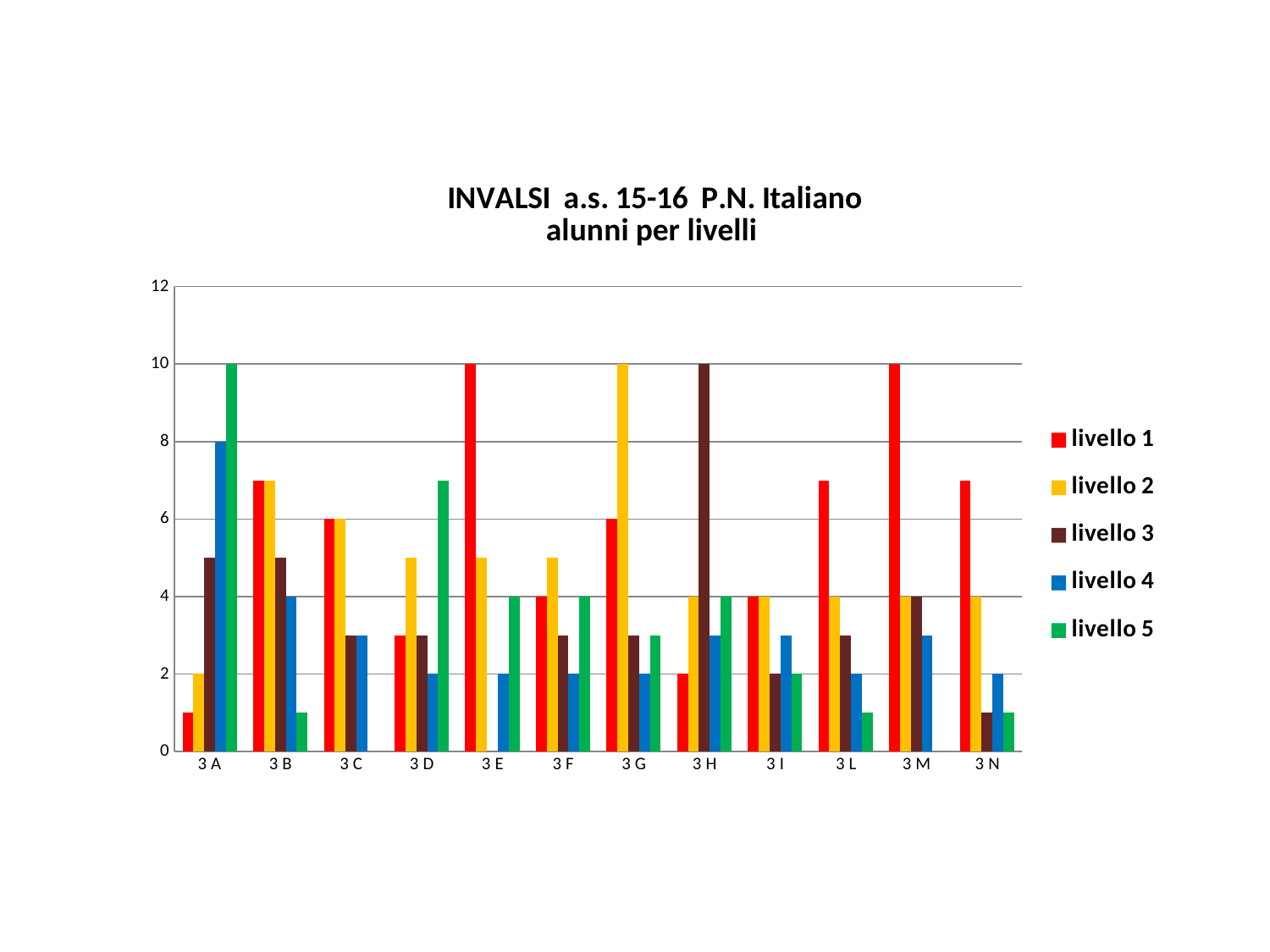
In class 3 H, which level has the highest value? livello 3 What is the value for livello 4 in class 3 A? 8 Is the value for livello 1 in class 3 B greater or less than 6? greater How many series does the legend list? 5 What kind of chart is shown on the slide? bar chart What is the difference between livello 5 and livello 4 in class 3 A? 2 Is the value for livello 5 in class 3 D greater or less than 6? greater What is the value for livello 1 in class 3 E? 10 What is the value for livello 5 in class 3 A? 10 How many classes (categories) are shown on the x axis? 12 What is the value for livello 3 in class 3 H? 10 What is the title of the chart? INVALSI a.s. 15-16 P.N. Italiano alunni per livelli